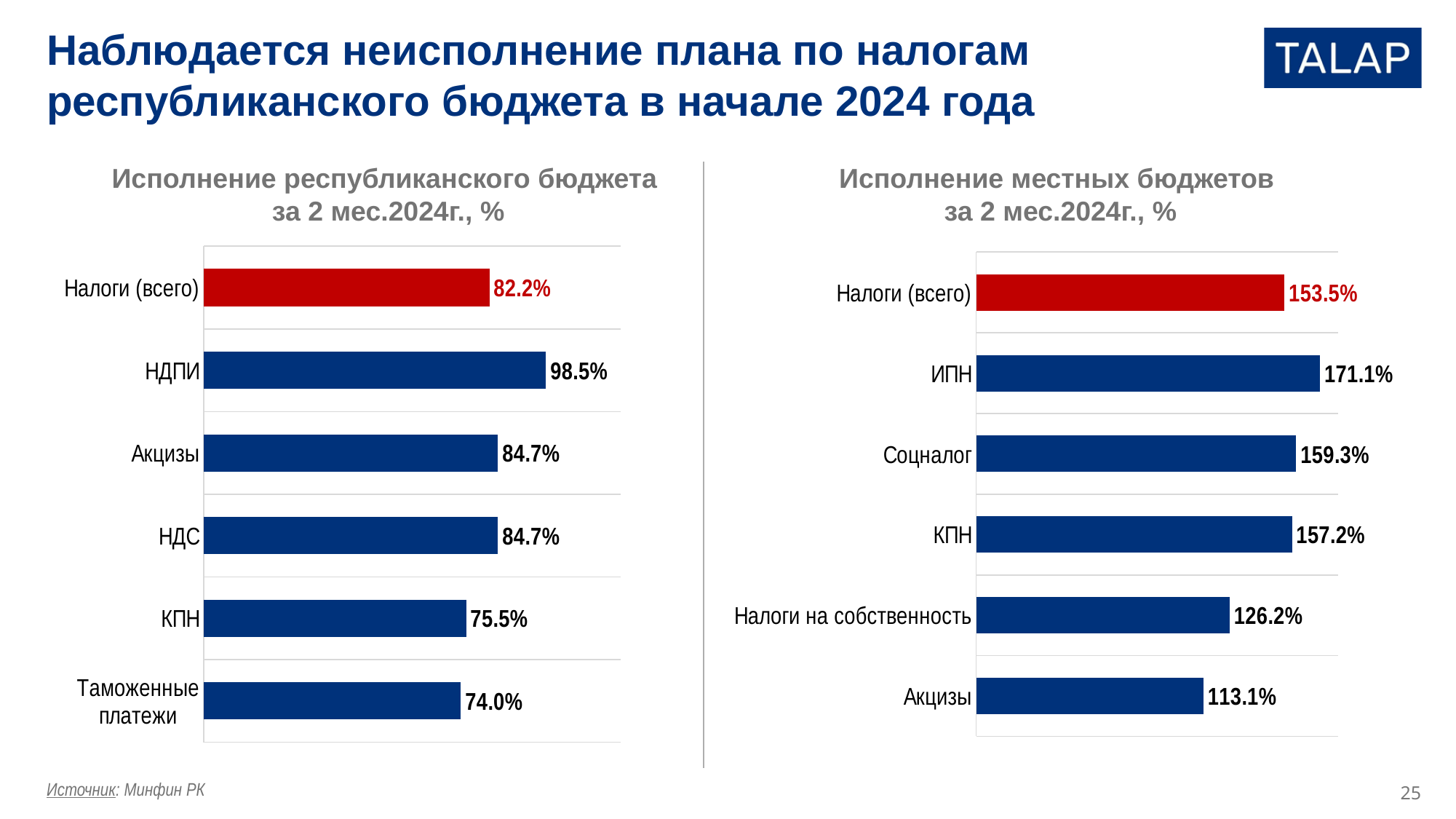
In the left chart (Исполнение республиканского бюджета), what is the value for Таможенные платежи? 74.0% In the left chart (Исполнение республиканского бюджета за 2 мес.2024г., %), what is the value for НДПИ? 98.5% How many categories are shown in the right chart (Исполнение местных бюджетов)? 6 In the left chart (Исполнение республиканского бюджета), which category has the highest value? НДПИ In the right chart (Исполнение местных бюджетов), which category has the lowest value? Акцизы In the right chart (Исполнение местных бюджетов), what is the value for Налоги (всего)? 153.5% In the left chart (Исполнение республиканского бюджета), which is larger: Акцизы or КПН? Акцизы In the left chart (Исполнение республиканского бюджета), what is the difference between НДПИ and КПН? 23.0% In the right chart (Исполнение местных бюджетов), what is the difference between ИПН and Акцизы? 58.0% In the right chart (Исполнение местных бюджетов за 2 мес.2024г., %), what is the value for Налоги на собственность? 126.2% What type of chart is the left chart (Исполнение республиканского бюджета)? Bar chart In the right chart (Исполнение местных бюджетов), which category has the highest value? ИПН